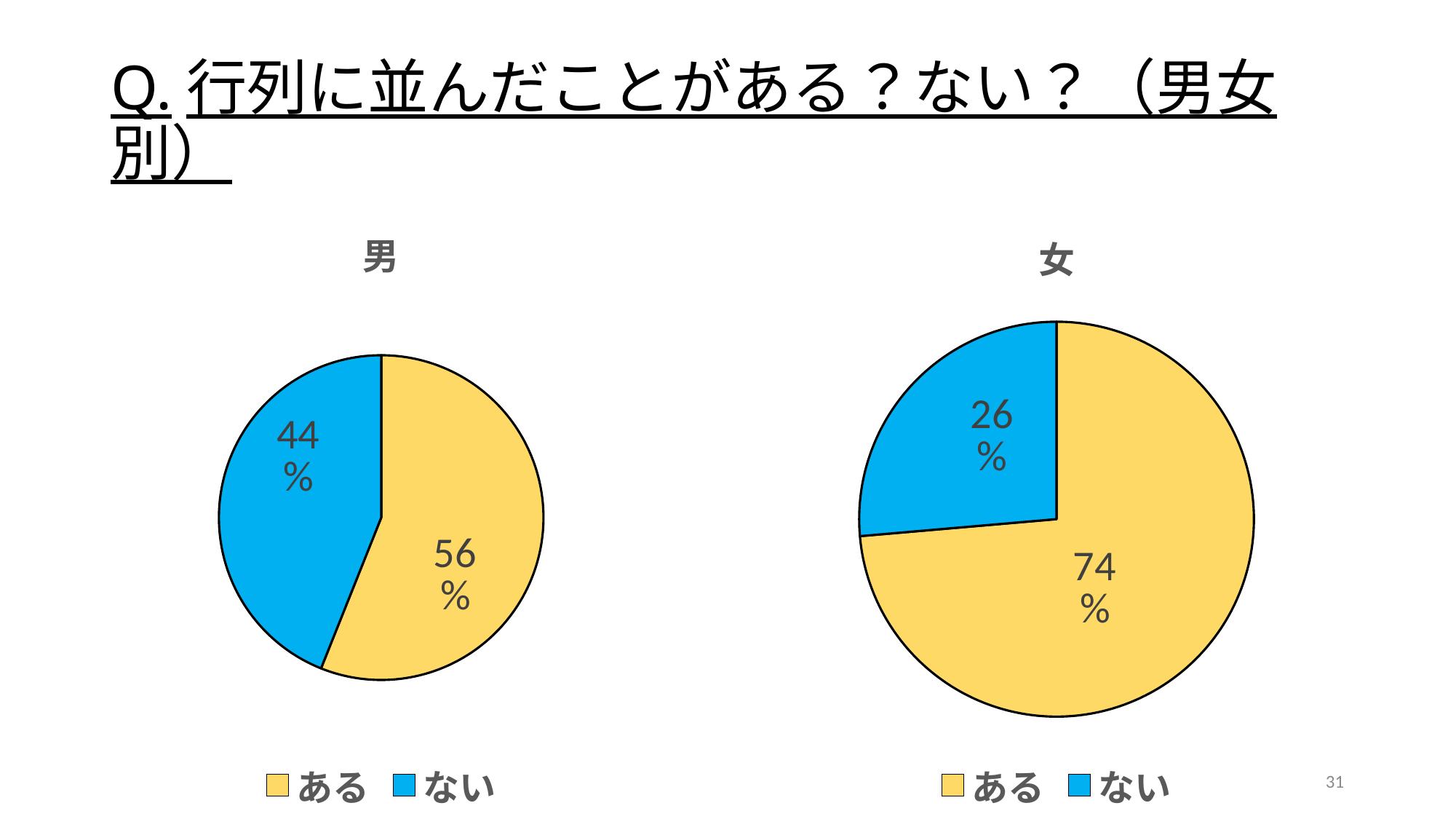
In the 男 (male) chart legend, what colour represents ない? Blue In the 男 (male) pie chart, what percentage is shown for ない? 44% In the 女 (female) pie chart, what is the difference between the ある and ない percentages? 48% In the 男 (male) pie chart, what percentage is shown for ある? 56% In the 女 (female) pie chart, what percentage is shown for ある? 74% In the 男 (male) pie chart, what is the difference between the ある and ない percentages? 12% In the 女 (female) pie chart, which slice is the largest? ある In the 男 (male) pie chart, which slice is the smallest? ない How many slices does the 女 (female) pie chart have? 2 In the 女 (female) pie chart, what percentage is shown for ない? 26% Which is larger: the ある share in the 男 chart or the ある share in the 女 chart? 女 What type of chart is used for the 男 (male) data? Pie chart